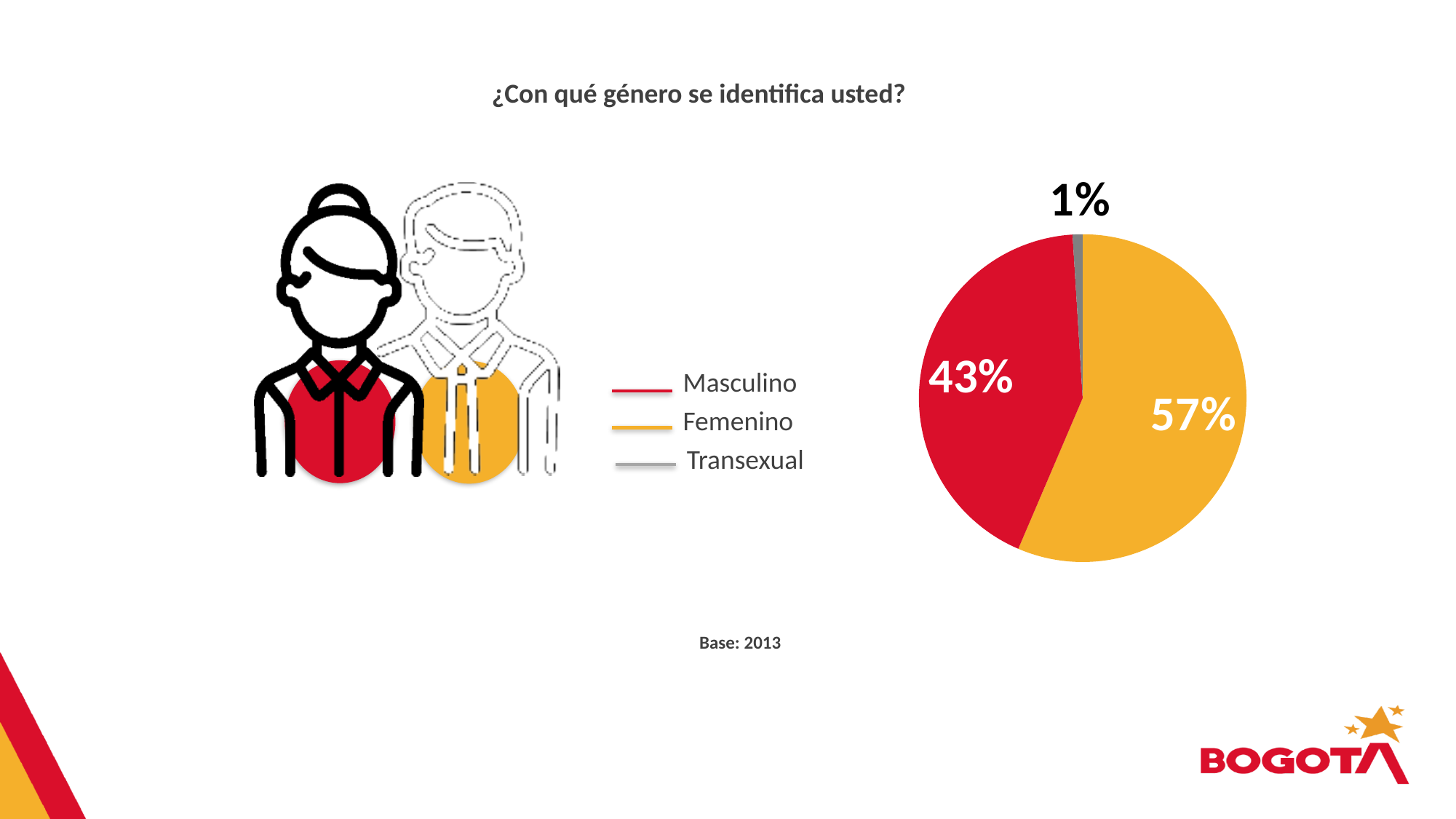
What type of chart is shown on the slide? Pie chart What percentage of respondents identified as Transexual? 1% What is the difference in percentage points between Femenino and Masculino? 14 What colour represents Masculino in the pie chart? Red What is the base (number of respondents) stated on the slide? 2013 Which is larger, the share for Masculino or the share for Femenino? Femenino How many categories are shown in the pie chart? 3 What percentage of respondents identified as Femenino? 57% What percentage of respondents identified as Masculino? 43% What is the question shown as the title of the chart? ¿Con qué género se identifica usted? Which gender category has the largest share of the pie? Femenino Which gender category has the smallest share of the pie? Transexual